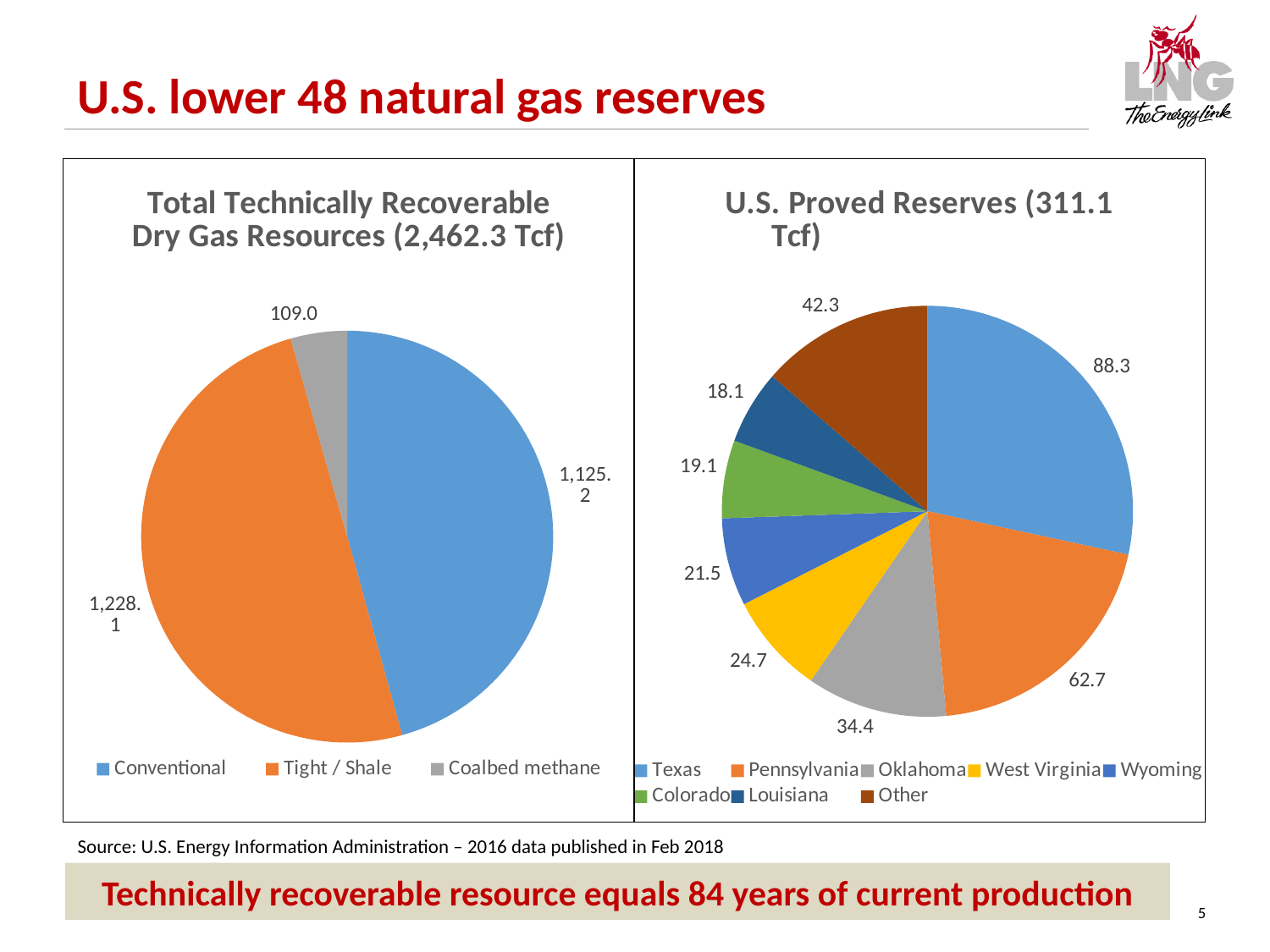
In the U.S. Proved Reserves chart, what is the value for Texas? 88.3 In the Total Technically Recoverable Dry Gas Resources chart, which category has the largest slice? Tight / Shale In the Total Technically Recoverable Dry Gas Resources chart, what is the difference between Tight / Shale and Conventional? 102.9 In the U.S. Proved Reserves chart, which state has the smallest slice? Louisiana In the Total Technically Recoverable Dry Gas Resources chart, how many categories are shown? 3 In the U.S. Proved Reserves chart, which is larger, Wyoming or Colorado? Wyoming In the Total Technically Recoverable Dry Gas Resources chart, what is the value for Coalbed methane? 109.0 In the U.S. Proved Reserves chart, what is the value for Oklahoma? 34.4 In the U.S. Proved Reserves chart, how many categories does the legend list? 8 In the U.S. Proved Reserves chart, what is the difference between Texas and Pennsylvania? 25.6 In the Total Technically Recoverable Dry Gas Resources chart, what is the value for Tight / Shale? 1,228.1 What type of chart is used on the right side of the slide? Pie chart